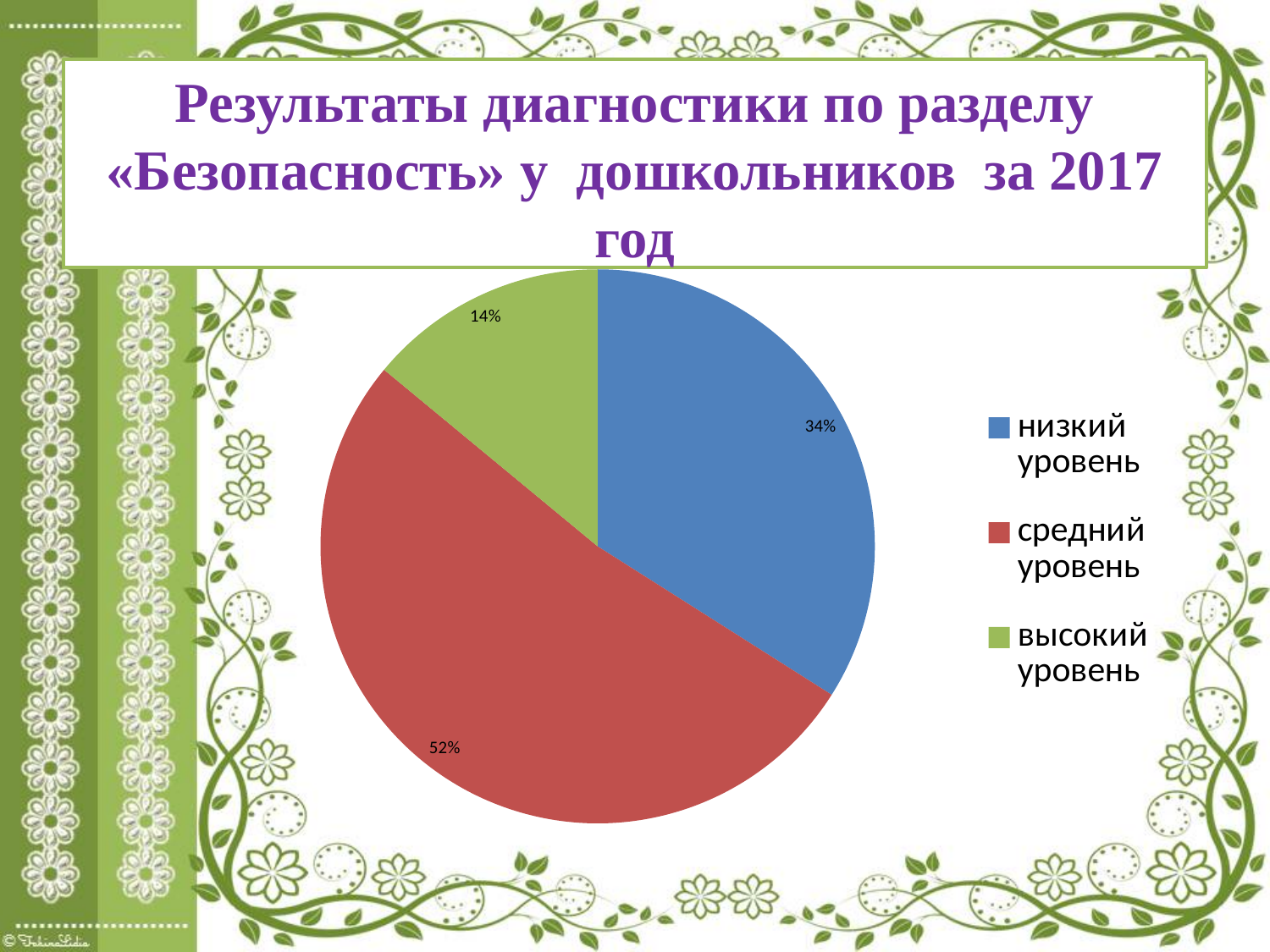
Which is larger, the share for низкий уровень or the share for высокий уровень? низкий уровень How many slices does the pie chart have? 3 Which level has the smallest share of the pie? высокий уровень What is the difference in percentage points between низкий уровень and высокий уровень? 20 What percentage is shown for низкий уровень? 34% What percentage is shown for высокий уровень? 14% What is the difference in percentage points between средний уровень and низкий уровень? 18 How many entries does the legend list? 3 What kind of chart is shown on the slide? pie chart What percentage is shown for средний уровень? 52% What colour is the slice for средний уровень? red Which level has the largest share of the pie? средний уровень